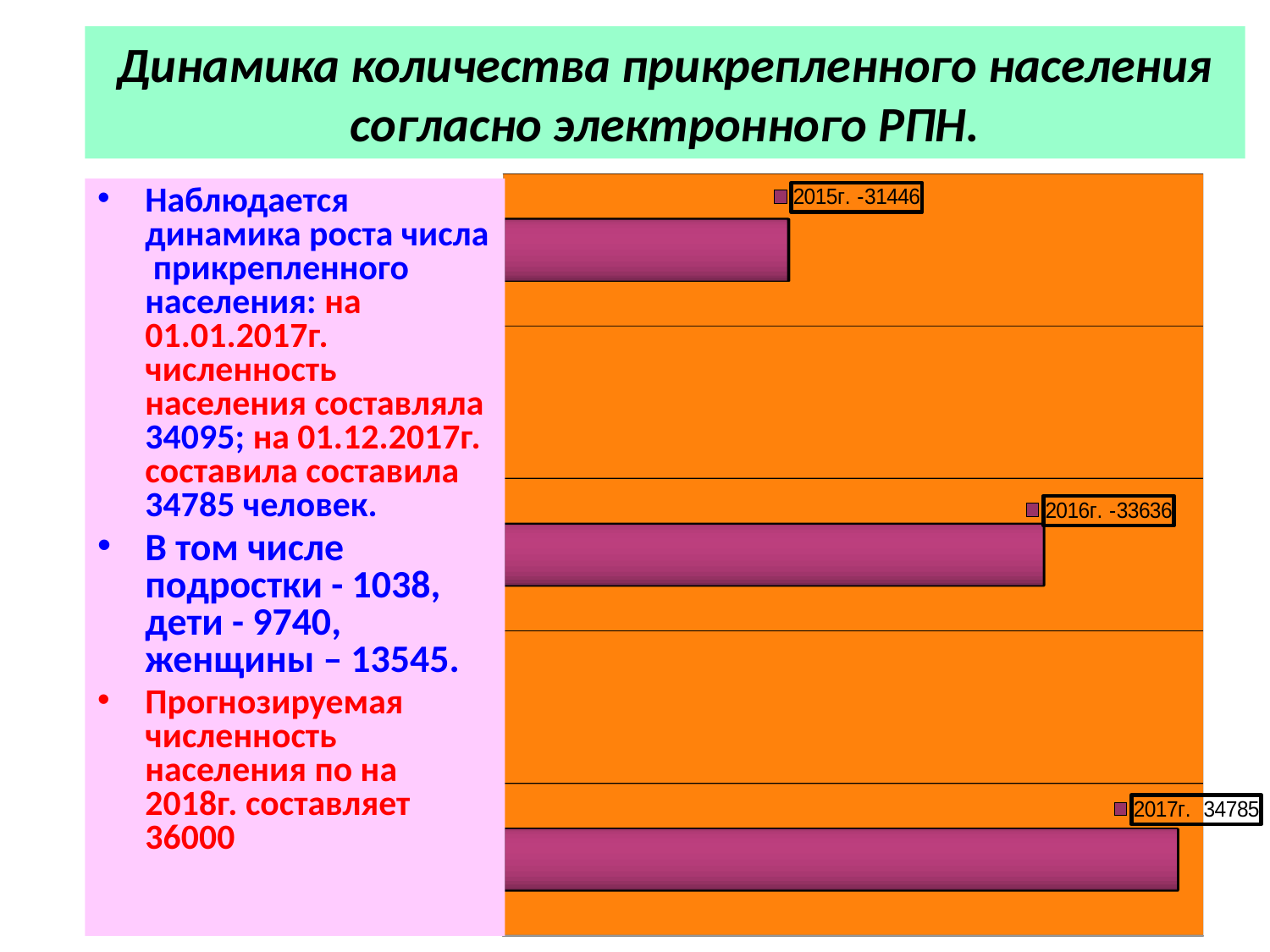
Do the values rise or fall from 2015г. to 2017г.? rise What is the difference between the values for 2017г. and 2015г.? 3339 What value is shown for 2017г. on the chart? 34785 Which year has the lowest value on the chart? 2015г. How many bars are plotted on the chart? 3 Which year has the highest value on the chart? 2017г. Which is larger, the value for 2016г. or the value for 2015г.? 2016г. What is the difference between the values for 2017г. and 2016г.? 1149 What kind of chart is shown on the slide? bar chart What value is shown for 2016г. on the chart? 33636 What is the difference between the values for 2016г. and 2015г.? 2190 What value is shown for 2015г. on the chart? 31446